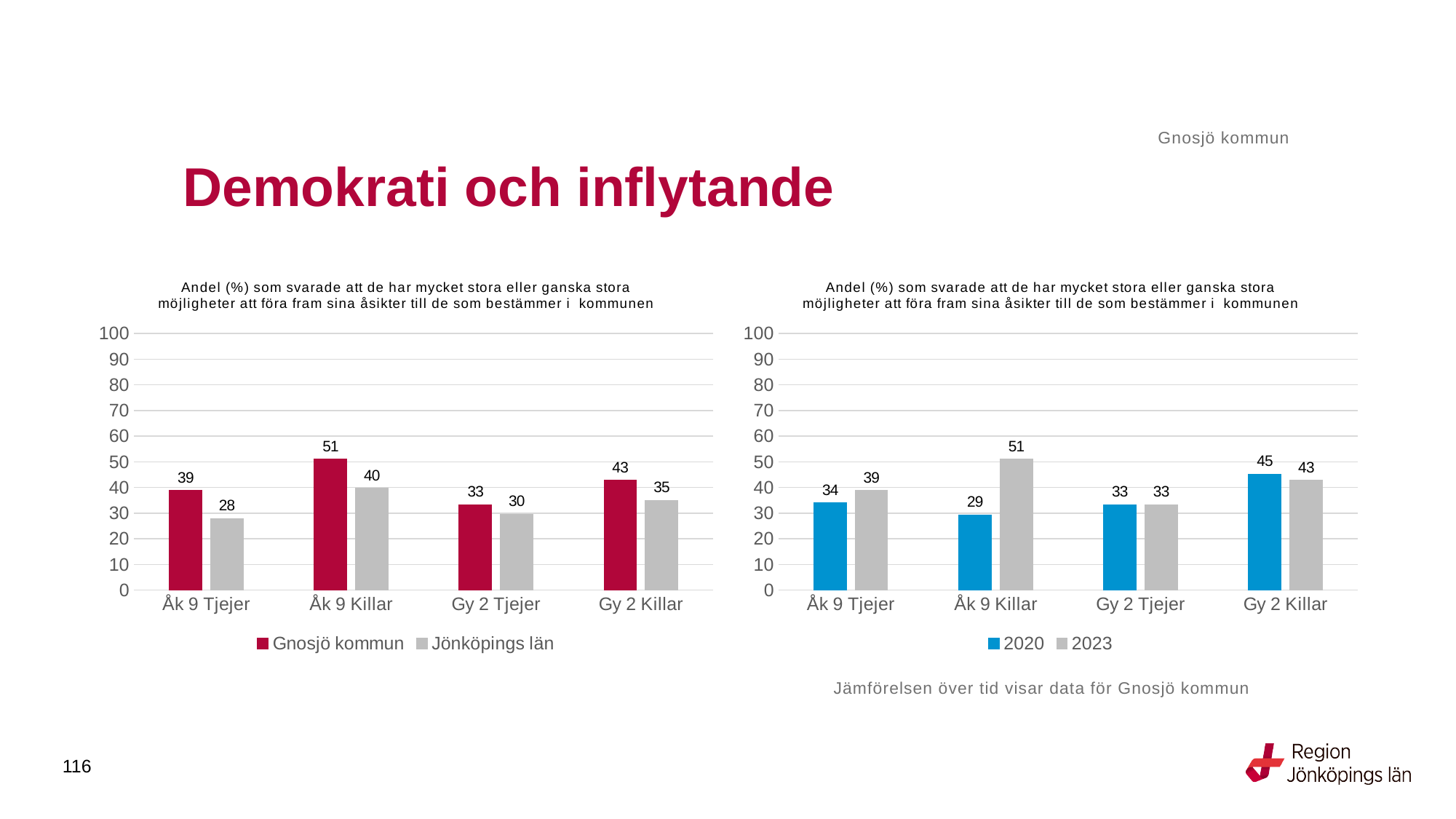
In the right chart, what is the 2020 value for Gy 2 Killar? 45 In the right chart, which category has the lowest 2020 value? Åk 9 Killar What kind of chart is the left chart? Bar chart In the right chart, which is larger for Gy 2 Killar: the 2020 value or the 2023 value? 2020 In the left chart, which category has the lowest value for Jönköpings län? Åk 9 Tjejer In the left chart, what is the value for Gnosjö kommun for Åk 9 Killar? 51 In the right chart, what is the 2023 value for Åk 9 Killar? 51 In the left chart, what is the value for Jönköpings län for Gy 2 Tjejer? 30 In the right chart, what is the difference between the 2023 and 2020 values for Åk 9 Killar? 22 In the left chart, what is the difference between Gnosjö kommun and Jönköpings län for Åk 9 Tjejer? 11 How many series does the legend of the right chart list? 2 How many categories are shown on the x axis of the left chart? 4